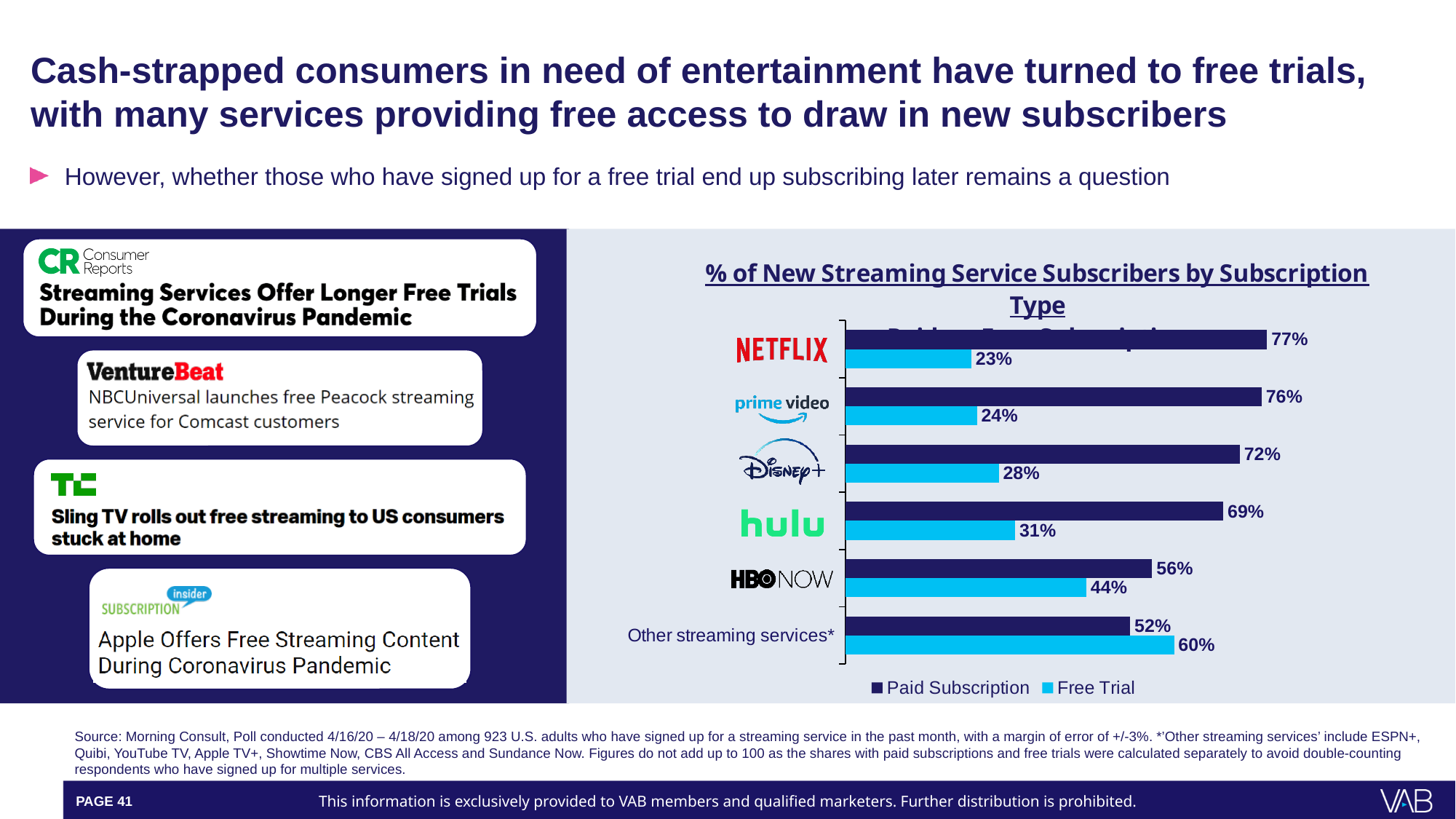
What is the difference between the Paid Subscription and Free Trial values for Hulu? 38% What is the difference between the Paid Subscription values for Netflix and Prime Video? 1% What is the Free Trial value for HBO NOW? 44% Which category has the lowest Paid Subscription value? Other streaming services* How many series does the legend list? 2 What is the Free Trial value for Disney+? 28% What is the title of the chart? % of New Streaming Service Subscribers by Subscription Type How many streaming service categories are shown in the chart? 6 Which category has the highest Free Trial value? Other streaming services* What is the Paid Subscription value for Netflix? 77% What kind of chart is shown on the slide? Bar chart Which is larger for Other streaming services*: Paid Subscription or Free Trial? Free Trial